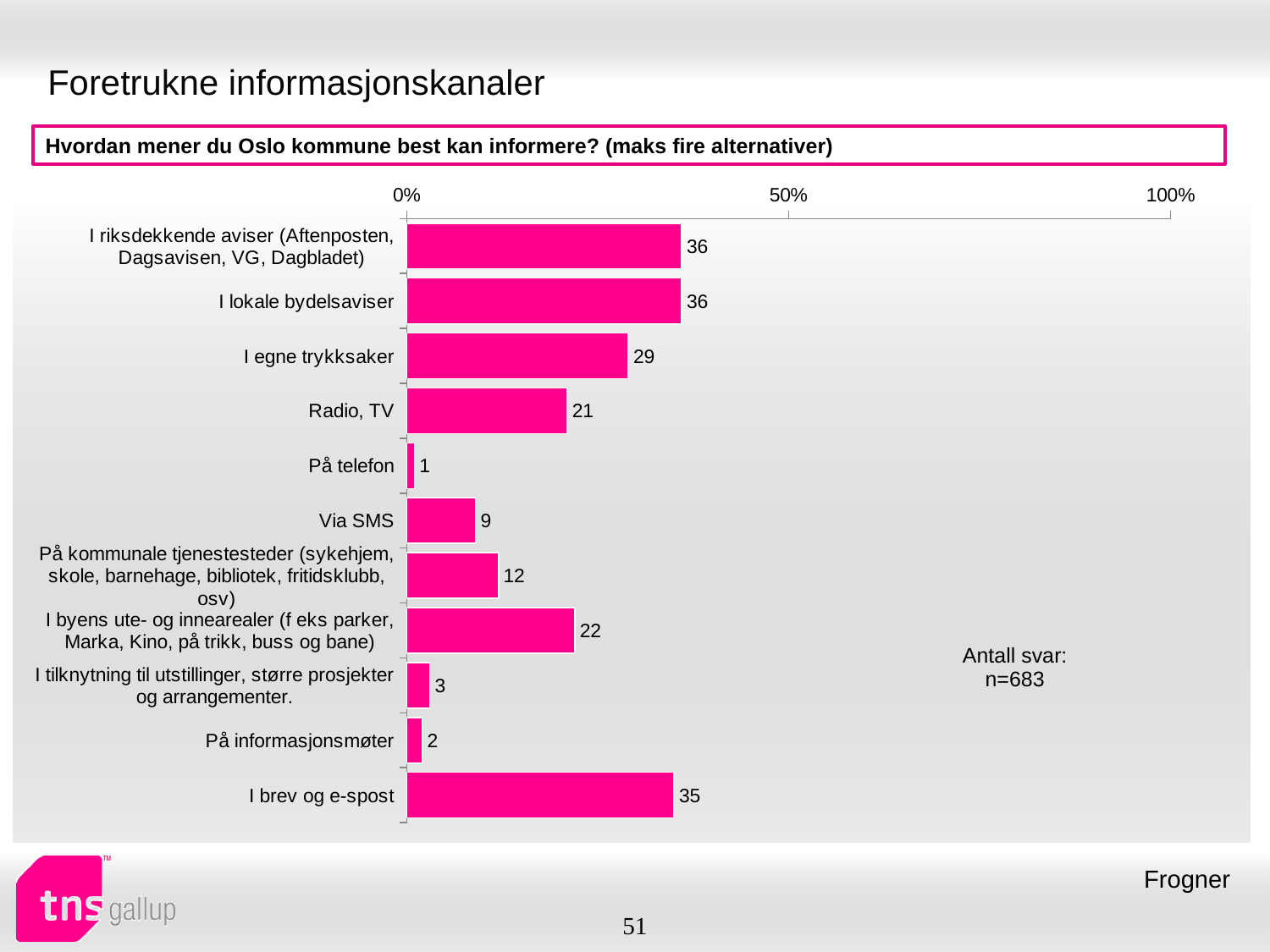
What is the number of responses (n) stated on the slide? n=683 Which is larger, the value for 'Via SMS' or the value for 'På kommunale tjenestesteder (sykehjem, skole, barnehage, bibliotek, fritidsklubb, osv)'? På kommunale tjenestesteder (sykehjem, skole, barnehage, bibliotek, fritidsklubb, osv) What is the value for 'I egne trykksaker'? 29 What is the difference between the values for 'I egne trykksaker' and 'Radio, TV'? 8 Is the value for 'I lokale bydelsaviser' greater or less than 50%? less What is the value for 'I brev og e-spost'? 35 What is the value for 'Via SMS'? 9 How many categories are shown in the chart? 11 Which category has the lowest value? På telefon What is the value for 'På informasjonsmøter'? 2 What kind of chart is shown on the slide? bar chart What is the value for 'Radio, TV'? 21